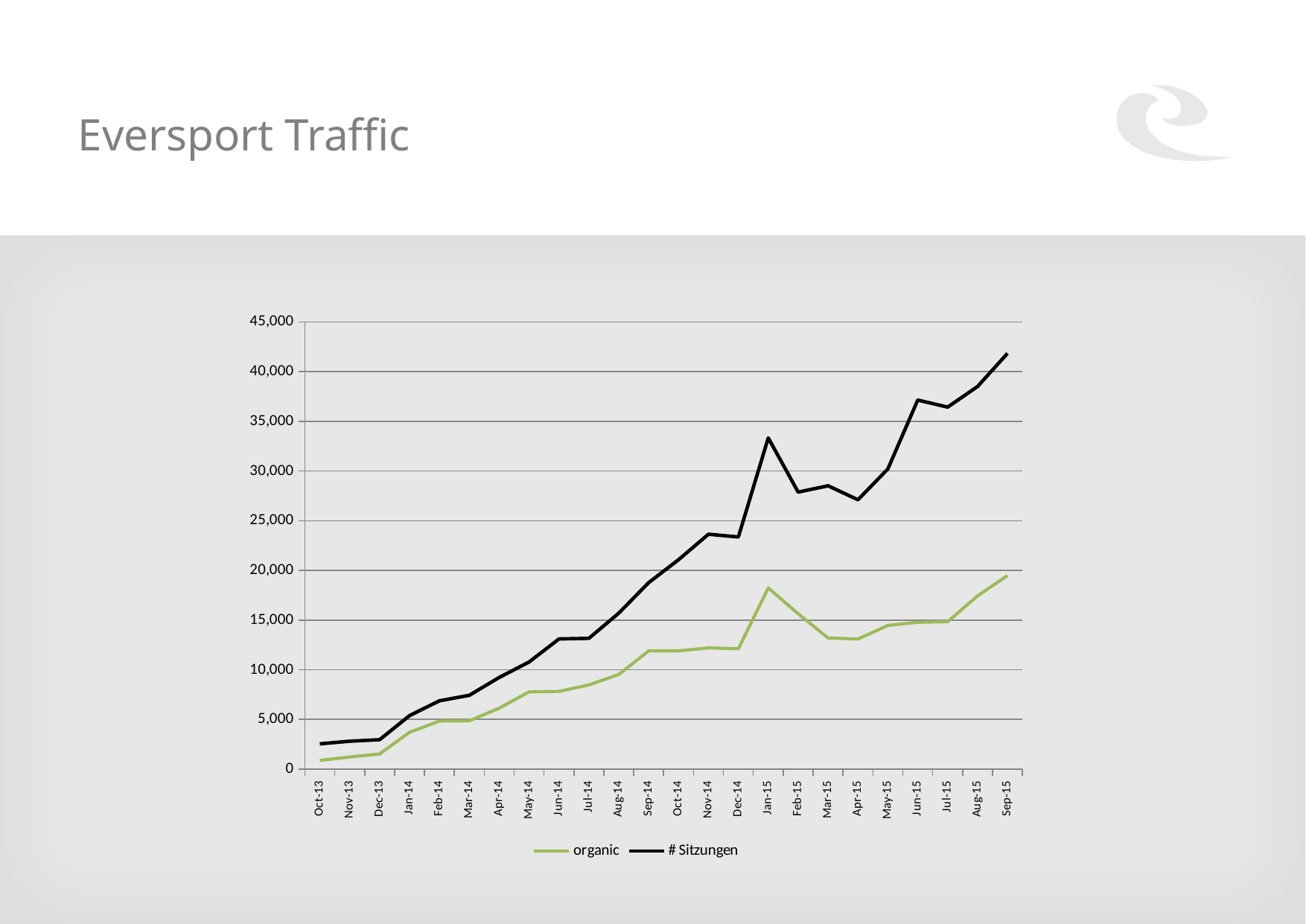
How many series does the legend list? 2 Which is larger for # Sitzungen: the value in Jan-15 or the value in Feb-15? Jan-15 Is the value for organic in Jan-15 greater or less than 15,000? greater Do the values of the # Sitzungen series generally rise or fall from Oct-13 to Sep-15? rise In which month is the organic series at its lowest value? Oct-13 In which month does the # Sitzungen series reach its highest value? Sep-15 What is the title of the slide containing the chart? Eversport Traffic How many months are plotted along the x axis? 24 What are the names of the two series in the legend? organic and # Sitzungen Is the value for # Sitzungen in Apr-15 greater or less than 30,000? less Is the value for # Sitzungen in Sep-15 greater or less than 40,000? greater What kind of chart is shown on the slide? line chart